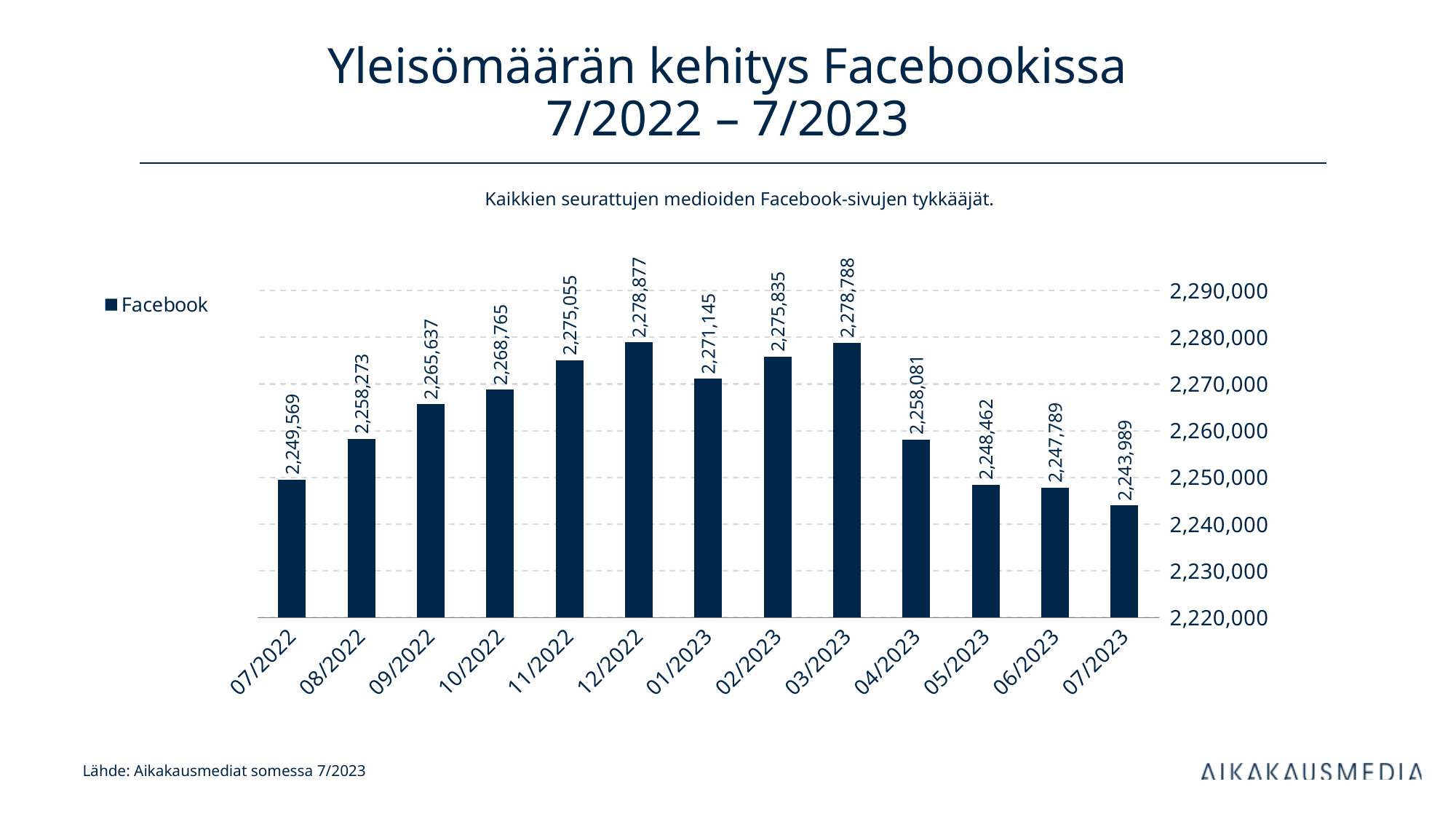
Which month has the highest value? 12/2022 What kind of chart is shown on the slide? bar chart What is the difference between the values for 07/2022 and 07/2023? 5,580 Which month has the lowest value? 07/2023 What is the Facebook audience value for 12/2022? 2,278,877 What is the value shown for 09/2022? 2,265,637 How many months are shown on the x axis? 13 How many series does the legend list? 1 Is the value for 05/2023 greater or less than 2,250,000? less Which is larger, the value for 11/2022 or the value for 04/2023? 11/2022 What is the difference between the values for 12/2022 and 07/2022? 29,308 What is the value shown for 07/2023? 2,243,989